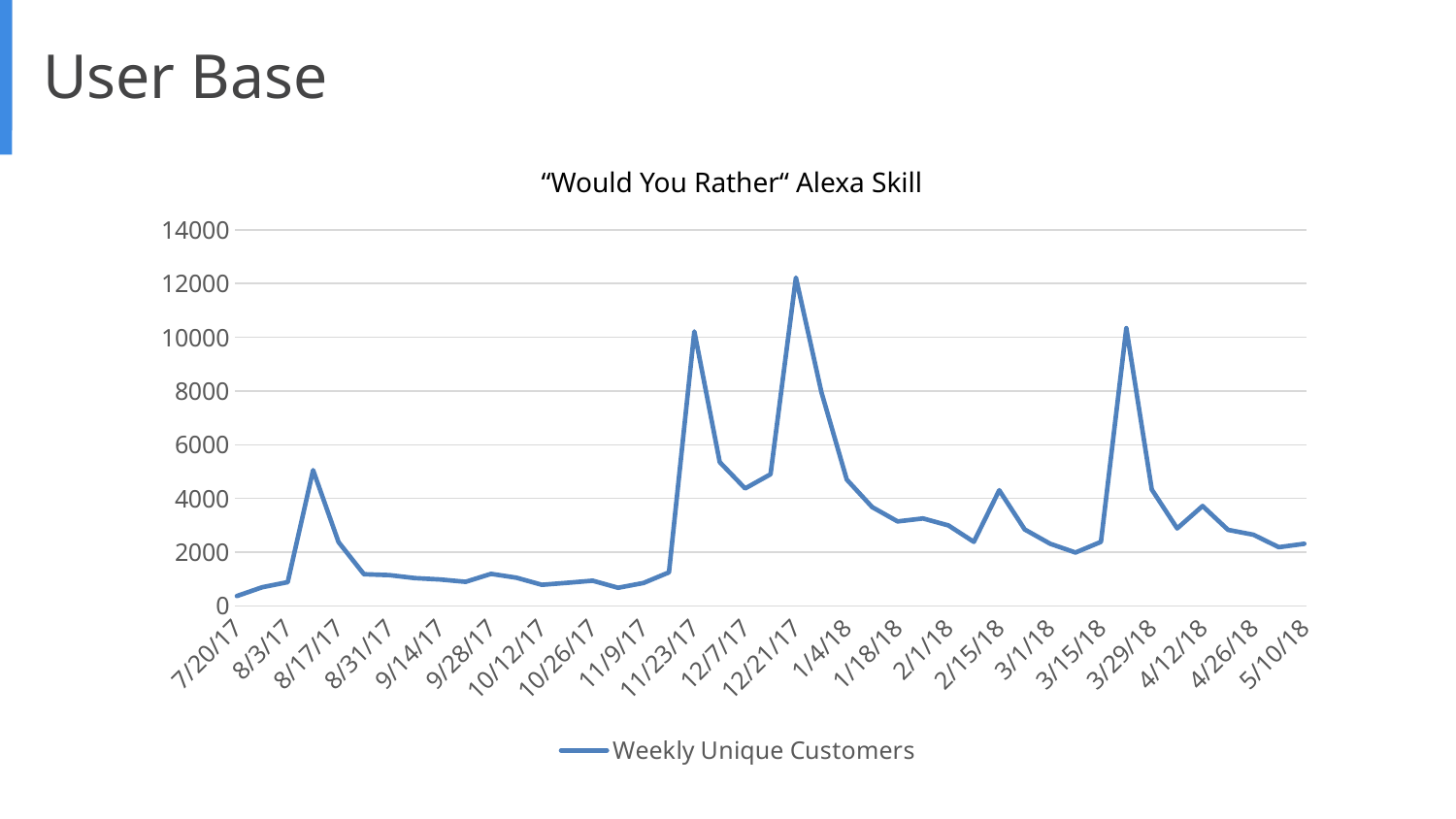
Which date has the higher value for Weekly Unique Customers, 12/21/17 or 11/23/17? 12/21/17 Do the values for Weekly Unique Customers rise or fall between 12/21/17 and 2/1/18? fall Is the value for Weekly Unique Customers on 3/29/18 greater or less than 6000? less What is the title of the chart? "Would You Rather" Alexa Skill Is the value for Weekly Unique Customers on 8/17/17 greater or less than 2000? greater Is the value for Weekly Unique Customers on 9/14/17 greater or less than 2000? less How many date labels are shown on the x axis? 22 What is the name of the series shown in the legend? Weekly Unique Customers How many series does the legend list? 1 On which labeled date does Weekly Unique Customers reach its highest value? 12/21/17 What kind of chart is shown on the slide? line chart